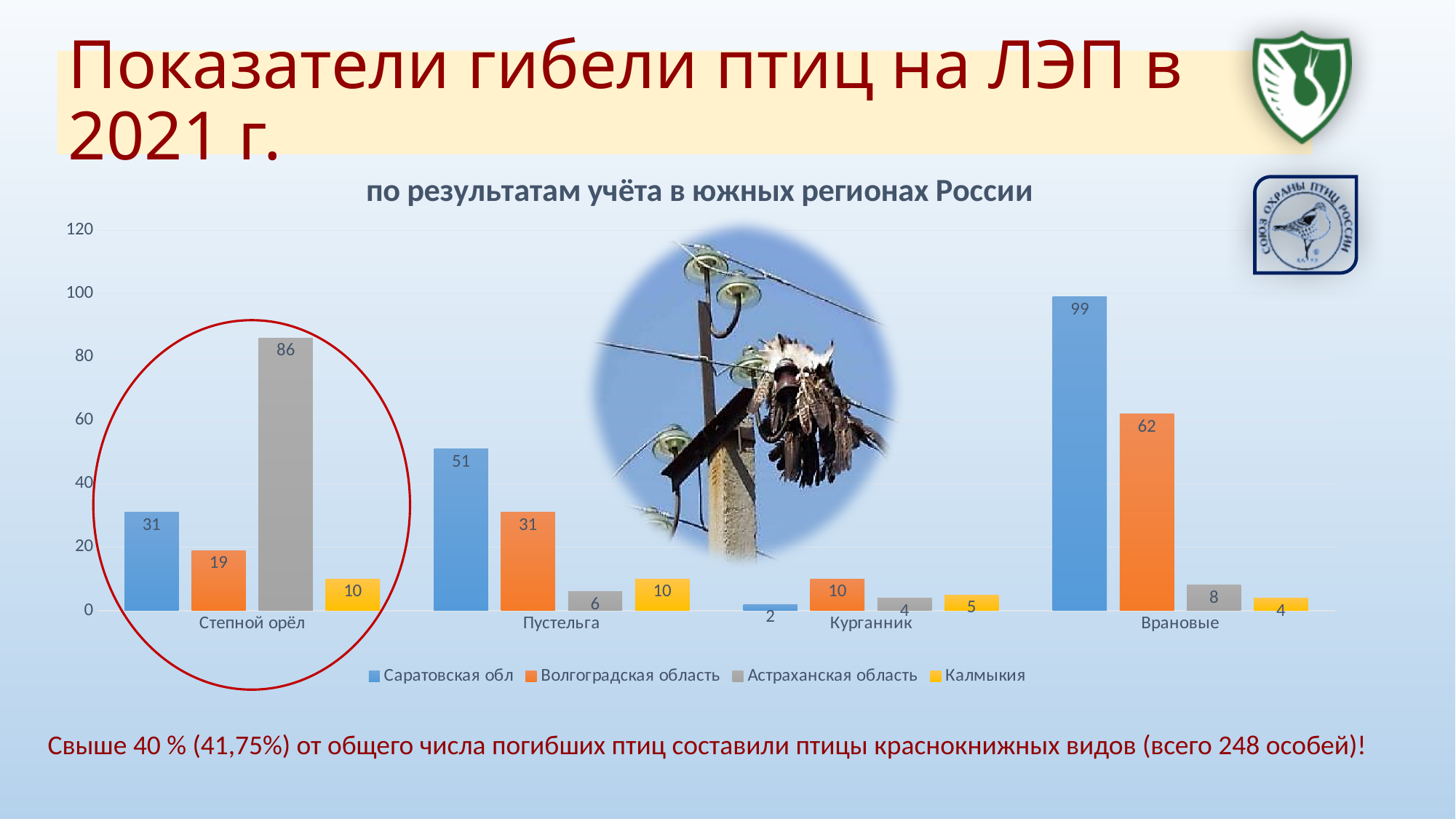
How many categories are shown on the x axis? 4 Which category has the lowest value for Саратовская обл? Курганник What kind of chart is shown on the slide? Bar chart What is the title of the chart? по результатам учёта в южных регионах России What is the value for Калмыкия for Курганник? 5 Which is larger for Степной орёл: the value for Саратовская обл or for Волгоградская область? Саратовская обл How many series does the legend list? 4 Which category has the highest value for Саратовская обл? Врановые What is the difference between the Саратовская обл and Волгоградская область values for Врановые? 37 What is the value for Астраханская область for Степной орёл? 86 What is the value for Волгоградская область for Пустельга? 31 What is the value for Саратовская обл for Врановые? 99